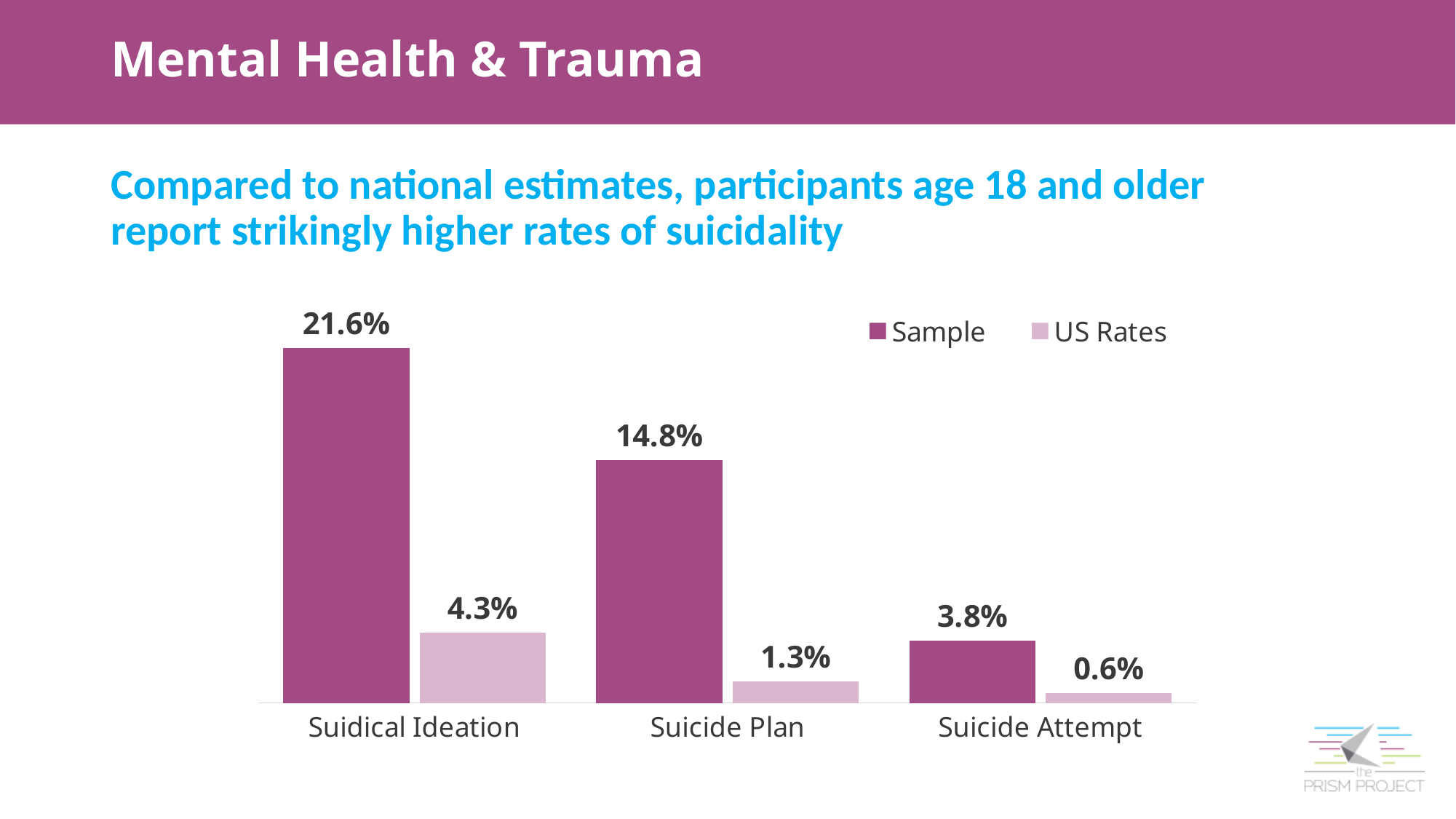
What kind of chart is shown on the slide? Bar chart What is the difference between the Sample and US Rates values for Suicide Plan? 13.5% Which is larger for Suicide Attempt, the Sample value or the US Rates value? Sample Which category has the highest Sample value? Suidical Ideation Which category has the lowest US Rates value? Suicide Attempt What is the Sample value for Suicide Attempt? 3.8% What is the US Rates value for Suicide Plan? 1.3% What is the Sample value for Suidical Ideation? 21.6% How many series does the legend list? 2 How many categories are shown on the x axis? 3 What is the US Rates value for Suidical Ideation? 4.3% Do the Sample values rise or fall from left to right along the x axis? Fall